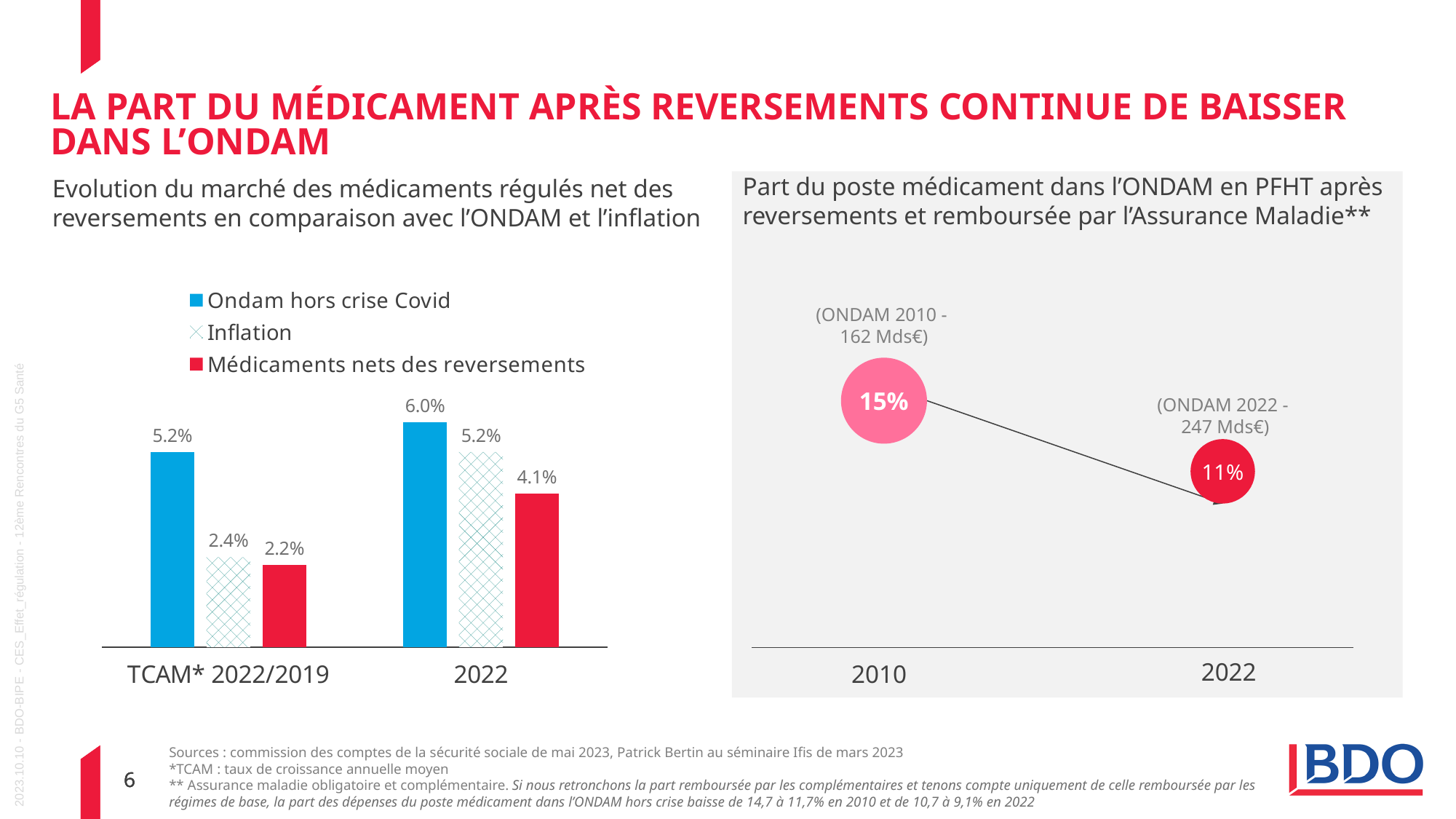
In the left chart, which series has the lowest value in 2022? Médicaments nets des reversements In the left chart, what is the value for Médicaments nets des reversements for TCAM* 2022/2019? 2.2% In the left chart, which series has the highest value for TCAM* 2022/2019? Ondam hors crise Covid What kind of chart is the left chart? Bar chart How many series does the legend of the left chart list? 3 In the right chart, what is the share of the medicament item in the ONDAM in 2010? 15% In the right chart, does the share rise or fall from 2010 to 2022? Fall In the left chart, which is larger for TCAM* 2022/2019: Inflation or Médicaments nets des reversements? Inflation In the left chart, what is the value for Ondam hors crise Covid in 2022? 6.0% In the left chart, what is the difference between Ondam hors crise Covid and Médicaments nets des reversements in 2022? 1.9% In the left chart, what is the value for Inflation in 2022? 5.2% In the right chart, what is the share of the medicament item in the ONDAM in 2022? 11%